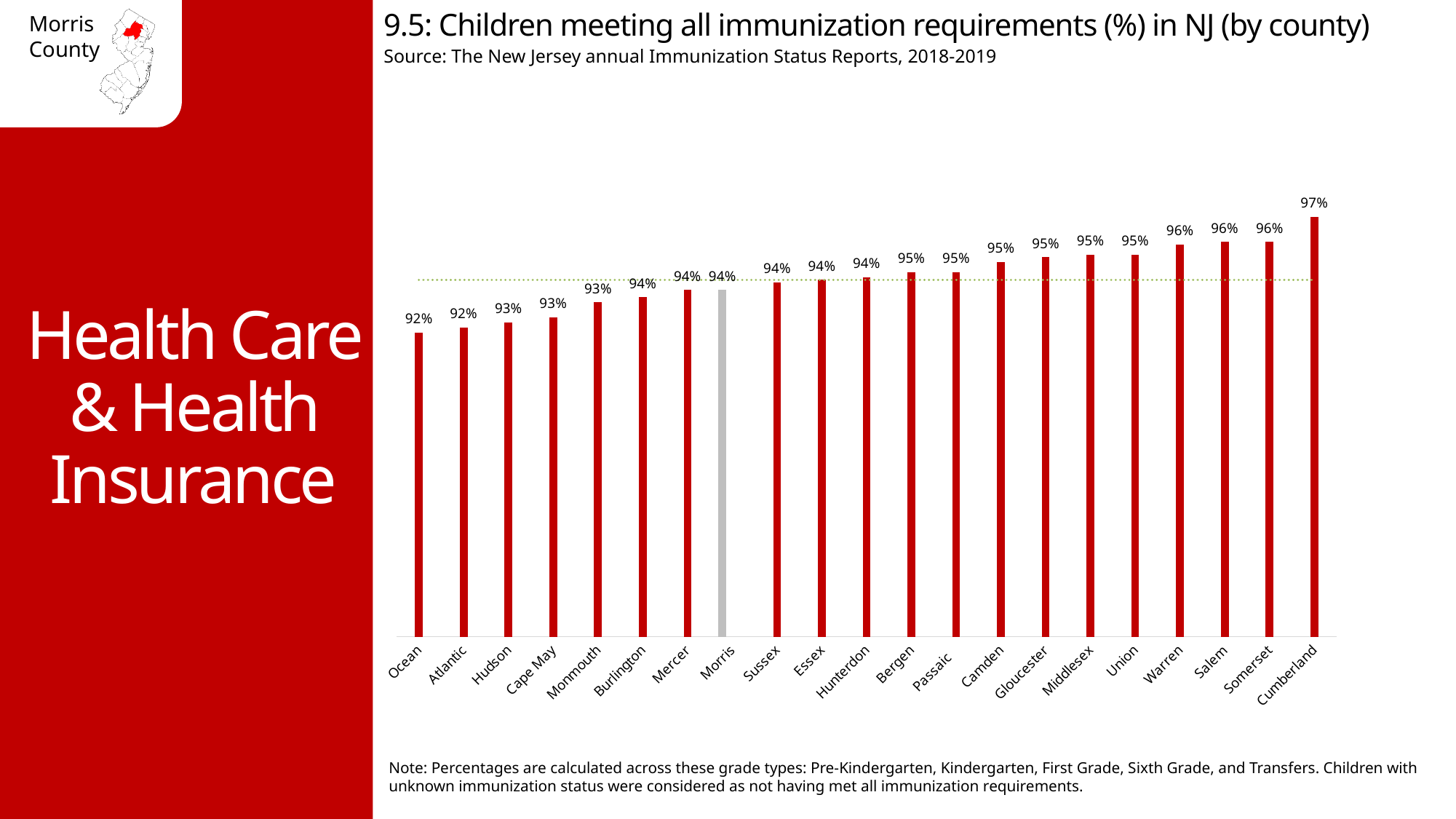
What is the value for Bergen? 95% What is the difference between the values for Cumberland and Morris? 3 percentage points What kind of chart is this? Bar chart Do the values rise or fall from left to right along the x axis? Rise How many counties are shown on the chart? 21 Which is larger, the value for Warren or the value for Hudson? Warren What is the value for Ocean? 92% What is the value for Cumberland? 97% Which county has the highest value? Cumberland What is the value for Morris? 94% What is the difference between the values for Cumberland and Ocean? 5 percentage points What is the lowest value shown on the chart? 92%